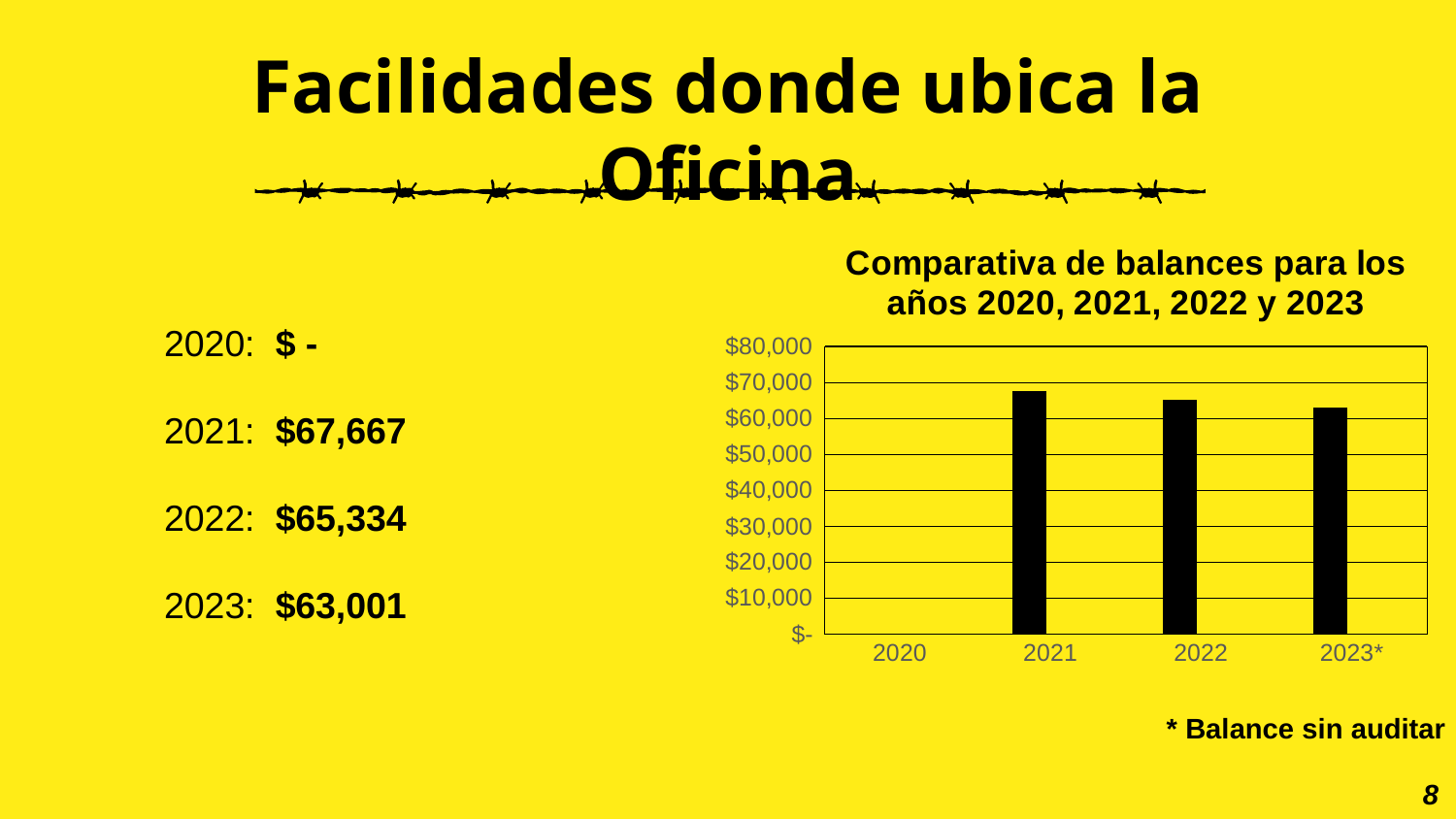
What is the balance value for 2022? $65,334 Is the value for 2022 greater or less than $70,000? less Do the balances rise or fall from 2021 to 2023? fall What is the balance value for 2023? $63,001 What is the difference between the balance for 2021 and the balance for 2023? $4,666 How many years (categories) are shown on the x axis of the chart? 4 What type of chart is shown on the slide? bar chart Which is larger, the balance for 2021 or the balance for 2022? 2021 Which year has the lowest balance in the chart? 2020 What is the title of the chart? Comparativa de balances para los años 2020, 2021, 2022 y 2023 What is the balance value for 2021? $67,667 Which year has the highest balance in the chart? 2021